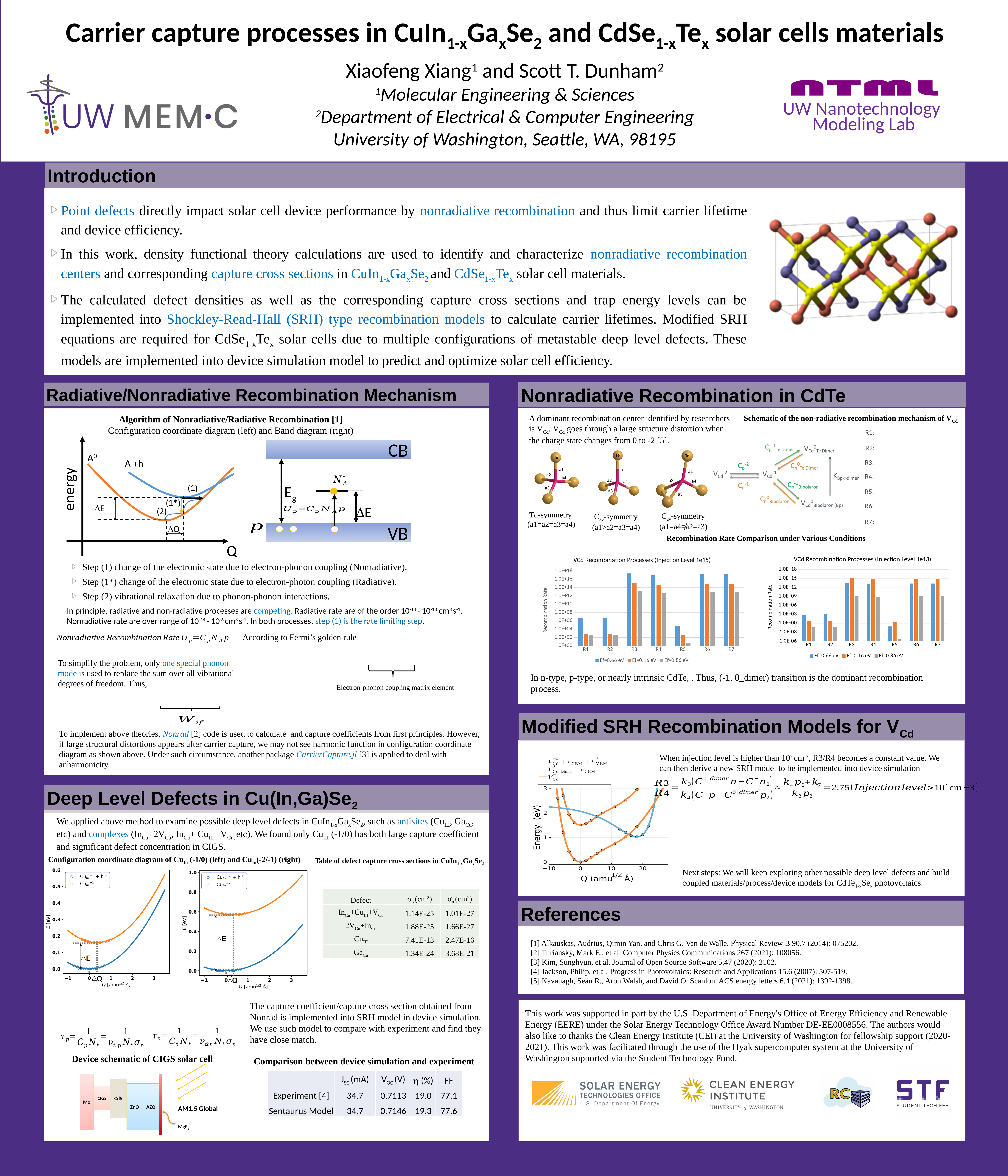
In the 'VCd Recombination Processes (Injection Level 1e13)' chart, what are the legend entries? Ef=0.66 eV, Ef=0.16 eV, Ef=0.86 eV In the 'VCd Recombination Processes (Injection Level 1e15)' chart, is the Ef=0.66 eV value for R5 greater or less than 1.0E+10? less What is the y-axis label of the 'VCd Recombination Processes (Injection Level 1e15)' chart? Recombination Rate In the 'VCd Recombination Processes (Injection Level 1e13)' chart, is the Ef=0.66 eV value for R1 greater or less than 1.0E+06? less In the 'VCd Recombination Processes (Injection Level 1e15)' chart, which category has the lowest Ef=0.66 eV value? R5 In the 'VCd Recombination Processes (Injection Level 1e13)' chart, for R3, which series has the larger value: Ef=0.16 eV or Ef=0.66 eV? Ef=0.16 eV In the 'VCd Recombination Processes (Injection Level 1e13)' chart, how many series does the legend list? 3 In the 'VCd Recombination Processes (Injection Level 1e15)' chart, how many categories are shown on the x axis? 7 In the 'VCd Recombination Processes (Injection Level 1e15)' chart, for R3, which series has the larger value: Ef=0.66 eV or Ef=0.86 eV? Ef=0.66 eV In the 'VCd Recombination Processes (Injection Level 1e15)' chart, is the Ef=0.66 eV value for R3 greater or less than 1.0E+12? greater What kind of chart is the 'VCd Recombination Processes (Injection Level 1e15)' chart? bar chart